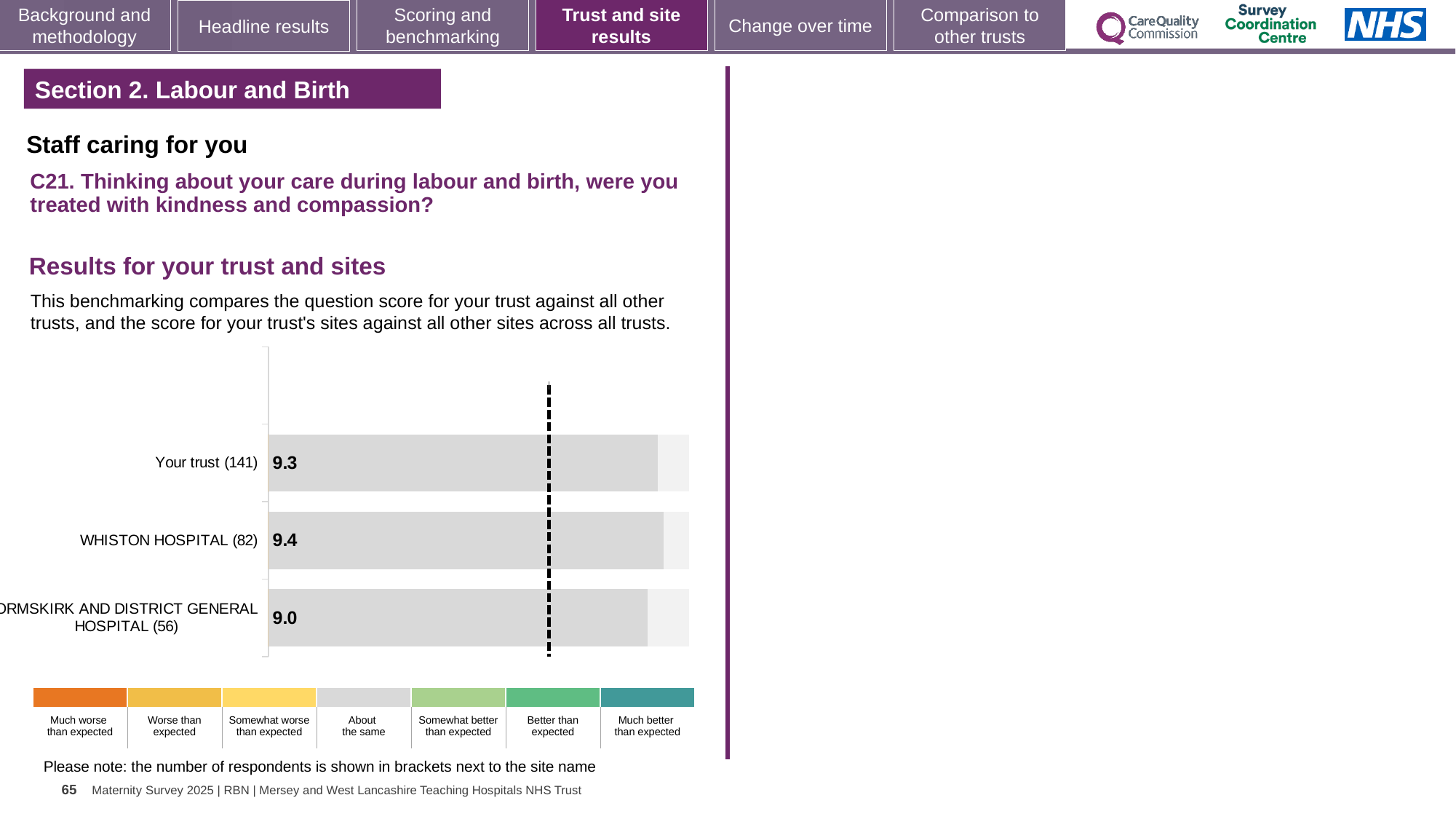
How many categories does the colour legend below the chart list? 7 Which site or trust has the lowest score? ORMSKIRK AND DISTRICT GENERAL HOSPITAL (56) What is the difference between the scores for WHISTON HOSPITAL (82) and ORMSKIRK AND DISTRICT GENERAL HOSPITAL (56)? 0.4 Which has a higher score, Your trust (141) or WHISTON HOSPITAL (82)? WHISTON HOSPITAL (82) What is the score for WHISTON HOSPITAL (82)? 9.4 What is the difference between the scores for Your trust (141) and ORMSKIRK AND DISTRICT GENERAL HOSPITAL (56)? 0.3 Which site or trust has the highest score? WHISTON HOSPITAL (82) How many respondents are shown in brackets for WHISTON HOSPITAL? 82 What kind of chart is shown on the slide? Bar chart How many bars are shown in the chart? 3 What is the score for Your trust (141)? 9.3 What is the score for ORMSKIRK AND DISTRICT GENERAL HOSPITAL (56)? 9.0